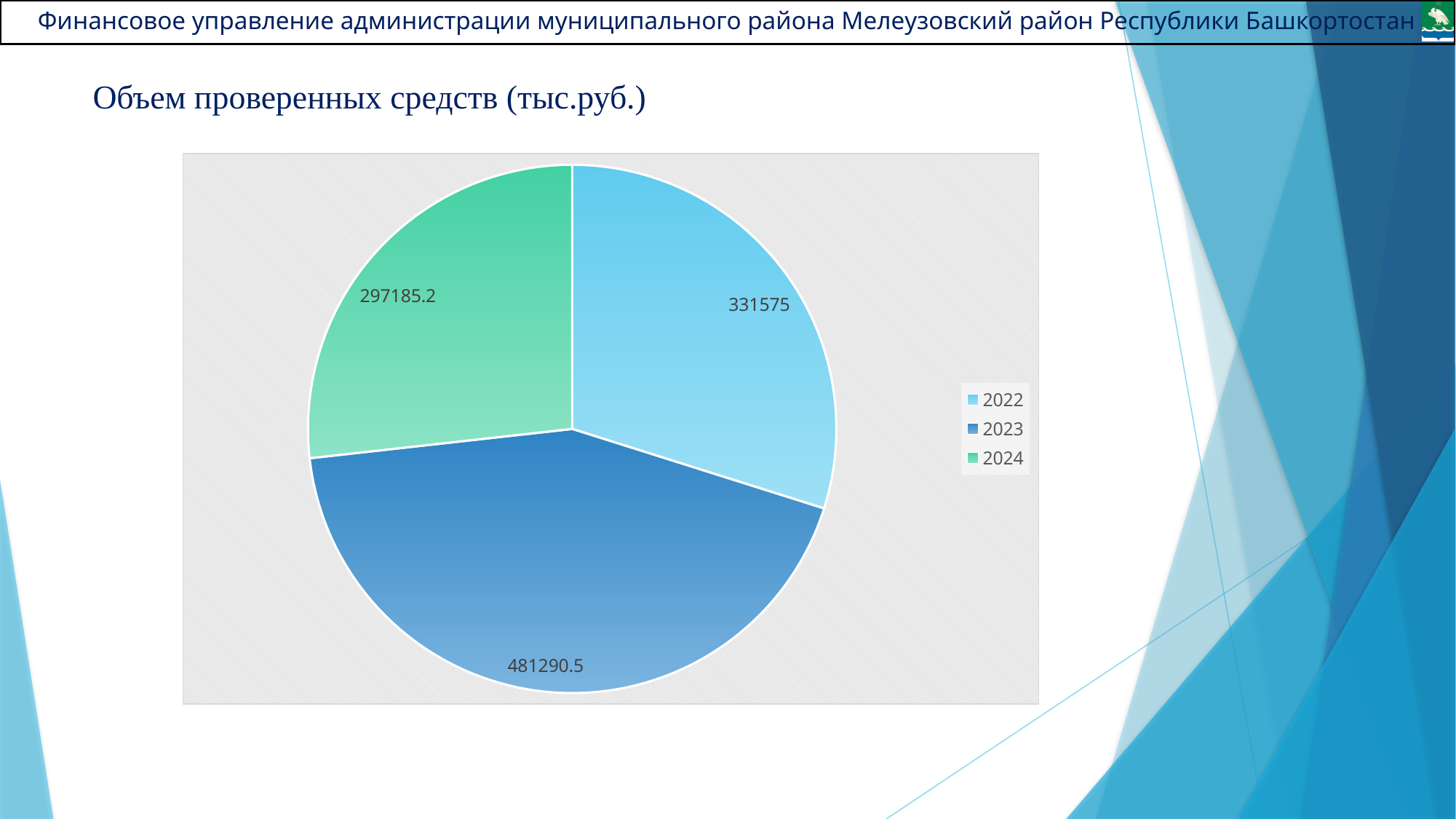
Which year has the smallest slice in the pie chart? 2024 Which is larger, the value for 2022 or the value for 2024? 2022 What is the title of the chart on the slide? Объем проверенных средств (тыс.руб.) How many slices does the pie chart have? 3 What type of chart is shown on the slide? Pie chart What is the value for 2024 in the pie chart? 297185.2 Which year has the largest slice in the pie chart? 2023 What is the difference between the values for 2022 and 2024? 34389.8 What is the value for 2022 in the pie chart? 331575 What is the value for 2023 in the pie chart? 481290.5 How many entries does the legend list? 3 What is the difference between the values for 2023 and 2022? 149715.5